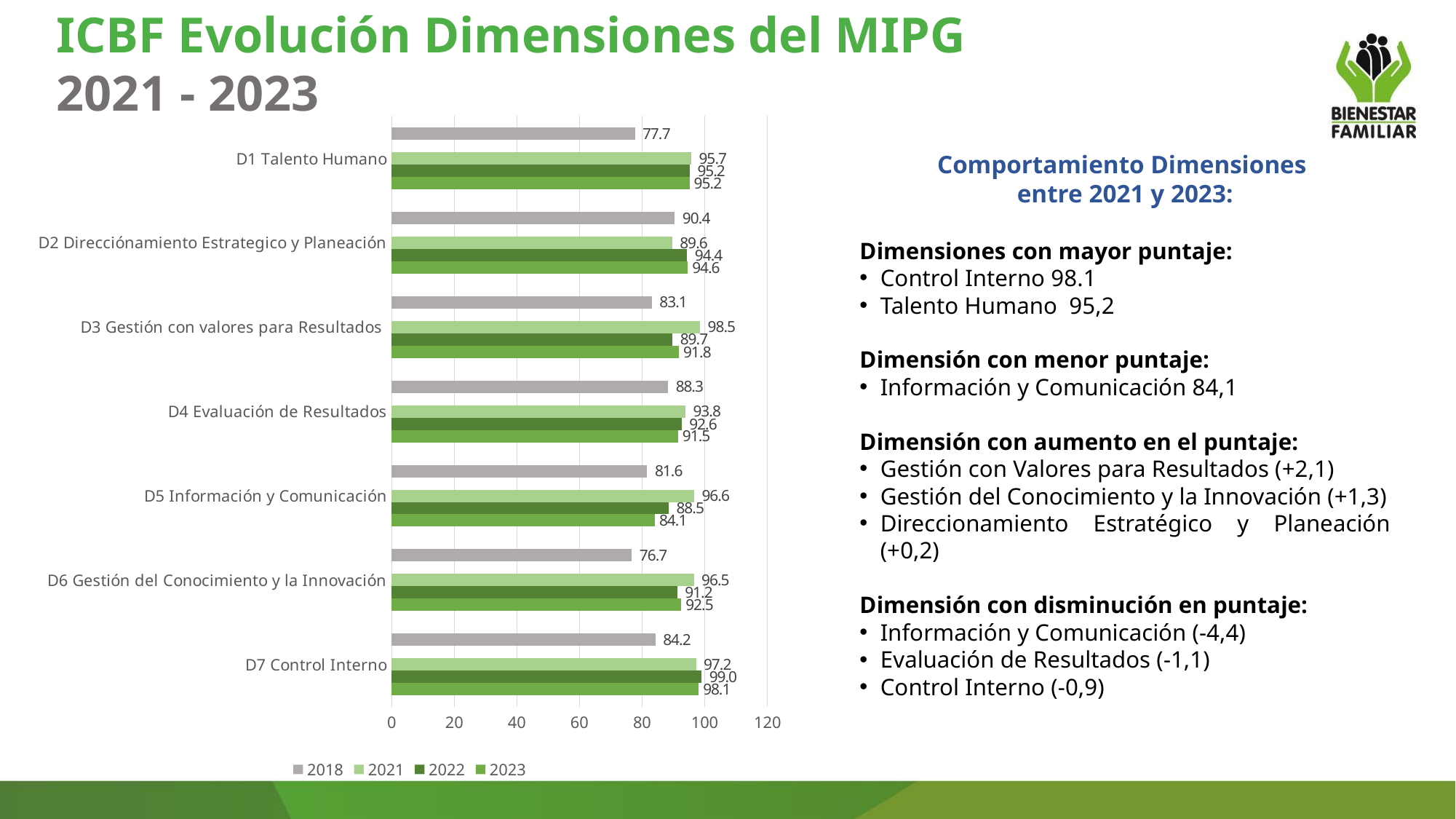
Is the 2018 value for D6 Gestión del Conocimiento y la Innovación greater or less than 80? less Which is larger for D2 Direcciónamiento Estrategico y Planeación: the 2018 value or the 2021 value? 2018 Which dimension has the lowest 2023 value? D5 Información y Comunicación What is the difference between the 2021 and 2023 values for D5 Información y Comunicación? 12.5 What is the 2023 value for D7 Control Interno? 98.1 What is the 2018 value for D1 Talento Humano? 77.7 How many series does the chart legend list? 4 How many dimensions (categories) are plotted in the chart? 7 What type of chart is shown on the slide? bar chart What is the 2021 value for D3 Gestión con valores para Resultados? 98.5 Which dimension has the highest 2022 value? D7 Control Interno Which legend entry is shown in grey? 2018